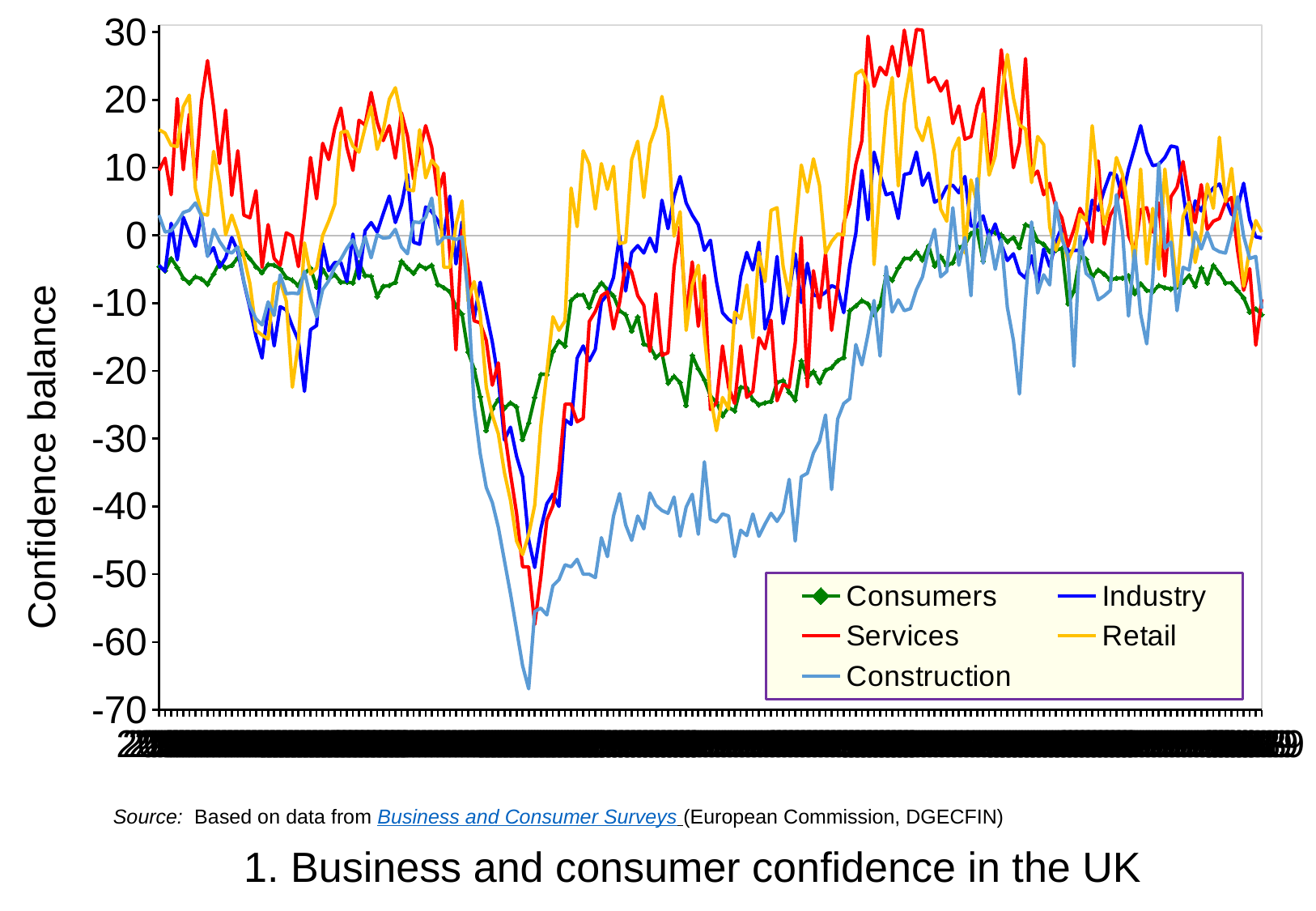
What kind of chart is shown on the slide? line chart Which series reaches the lowest value on the chart? Construction Is the lowest value of the Services series greater or less than -50? less Is the lowest value of the Industry series greater or less than -40? less How many series does the legend list? 5 Is the highest value of the Consumers series greater or less than 10? less Which series are listed in the legend? Consumers, Industry, Services, Retail, Construction Which series falls to a lower minimum, Construction or Consumers? Construction What is the label on the vertical axis? Confidence balance